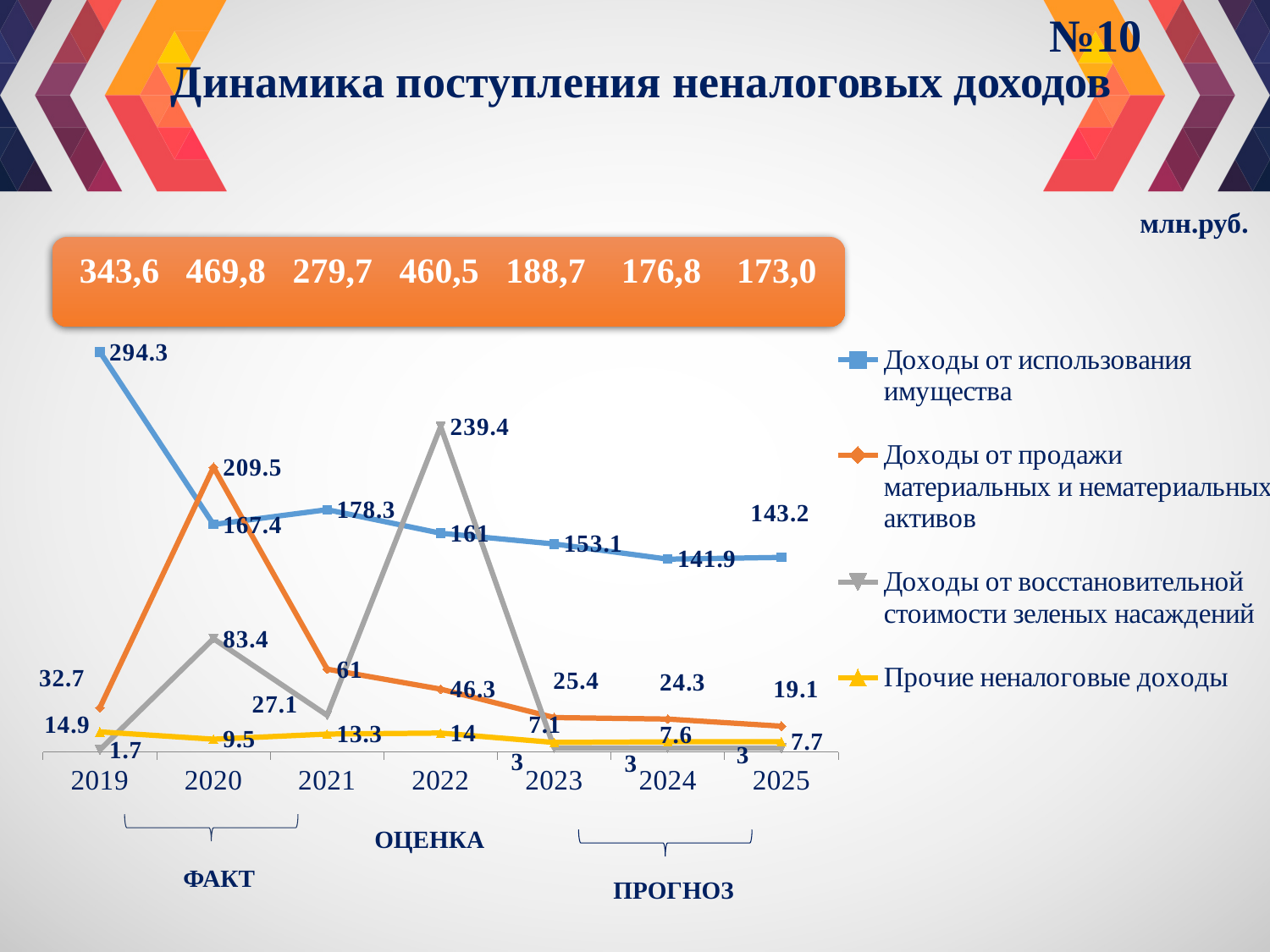
In which year is Доходы от использования имущества highest? 2019 What is the difference between Доходы от использования имущества in 2019 and in 2020? 126.9 What is the value for Доходы от продажи материальных и нематериальных активов in 2020? 209.5 How many series does the legend list? 4 Which is larger in 2022: Доходы от использования имущества or Доходы от восстановительной стоимости зеленых насаждений? Доходы от восстановительной стоимости зеленых насаждений How many years are shown on the x axis? 7 What is the value for Прочие неналоговые доходы in 2025? 7.7 What kind of chart is shown on the slide? line chart What is the value for Доходы от восстановительной стоимости зеленых насаждений in 2022? 239.4 In which year is Доходы от продажи материальных и нематериальных активов lowest? 2025 What is the value for Доходы от использования имущества in 2019? 294.3 What unit of measurement is indicated for the chart? млн.руб.